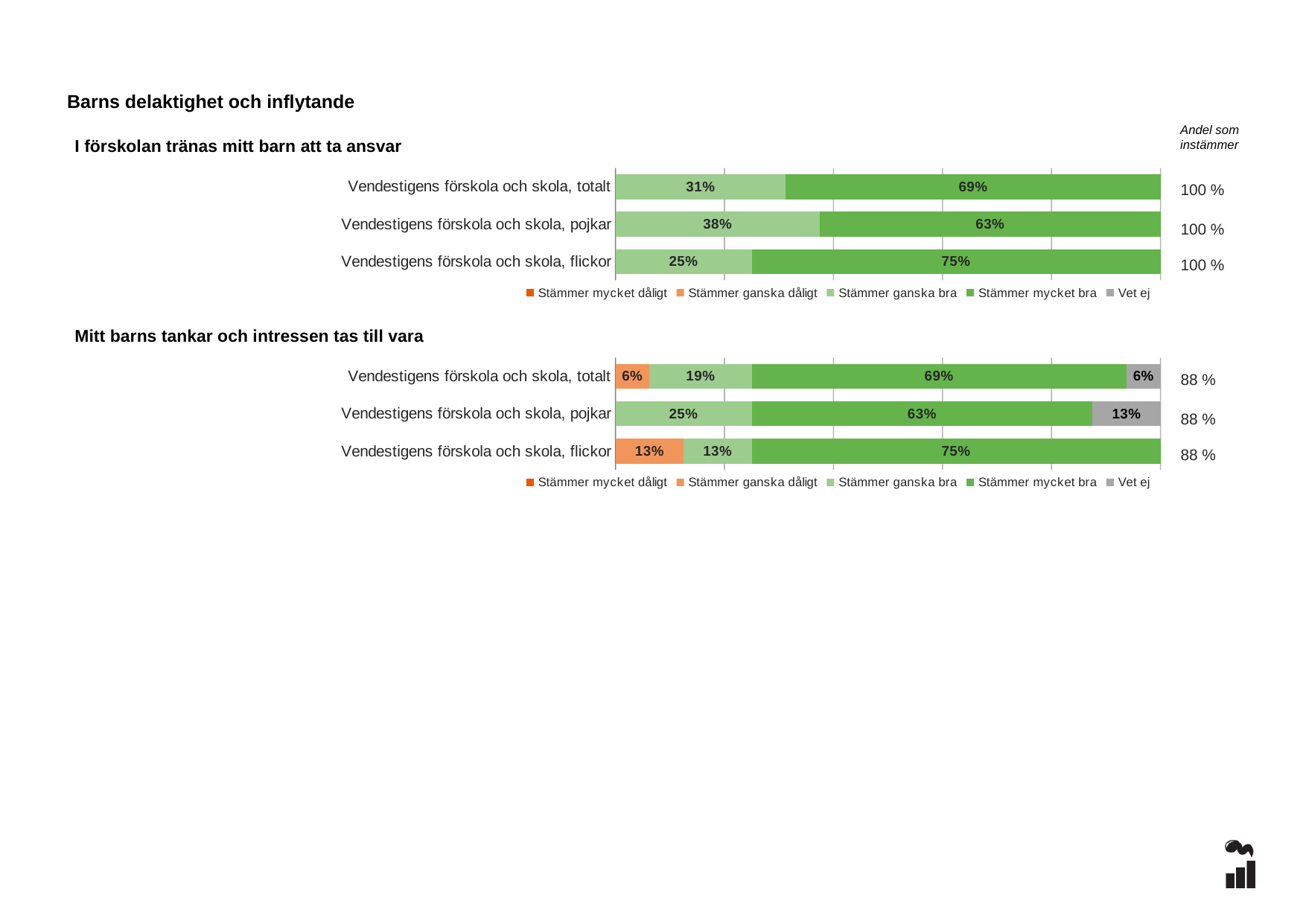
How many series does the legend of the chart 'Mitt barns tankar och intressen tas till vara' list? 5 In the chart 'I förskolan tränas mitt barn att ta ansvar', what is the 'Stämmer mycket bra' value for Vendestigens förskola och skola, flickor? 75% What kind of chart is 'Mitt barns tankar och intressen tas till vara'? Stacked bar chart In the chart 'I förskolan tränas mitt barn att ta ansvar', which category has the lowest 'Stämmer ganska bra' value? Vendestigens förskola och skola, flickor In the chart 'Mitt barns tankar och intressen tas till vara', what is the 'Stämmer ganska dåligt' value for Vendestigens förskola och skola, totalt? 6% In the chart 'I förskolan tränas mitt barn att ta ansvar', which category has the highest 'Stämmer mycket bra' value? Vendestigens förskola och skola, flickor In the chart 'I förskolan tränas mitt barn att ta ansvar', what is the 'Stämmer ganska bra' value for Vendestigens förskola och skola, pojkar? 38% In the chart 'Mitt barns tankar och intressen tas till vara', what is the 'Vet ej' value for Vendestigens förskola och skola, pojkar? 13% In the chart 'Mitt barns tankar och intressen tas till vara', what is the 'Andel som instämmer' value shown for Vendestigens förskola och skola, totalt? 88 % In the chart 'Mitt barns tankar och intressen tas till vara', what is the difference between the 'Stämmer mycket bra' values for flickor and pojkar? 12% How many categories are shown in the chart 'I förskolan tränas mitt barn att ta ansvar'? 3 In the chart 'I förskolan tränas mitt barn att ta ansvar', is the 'Stämmer ganska bra' value larger for pojkar or for totalt? pojkar